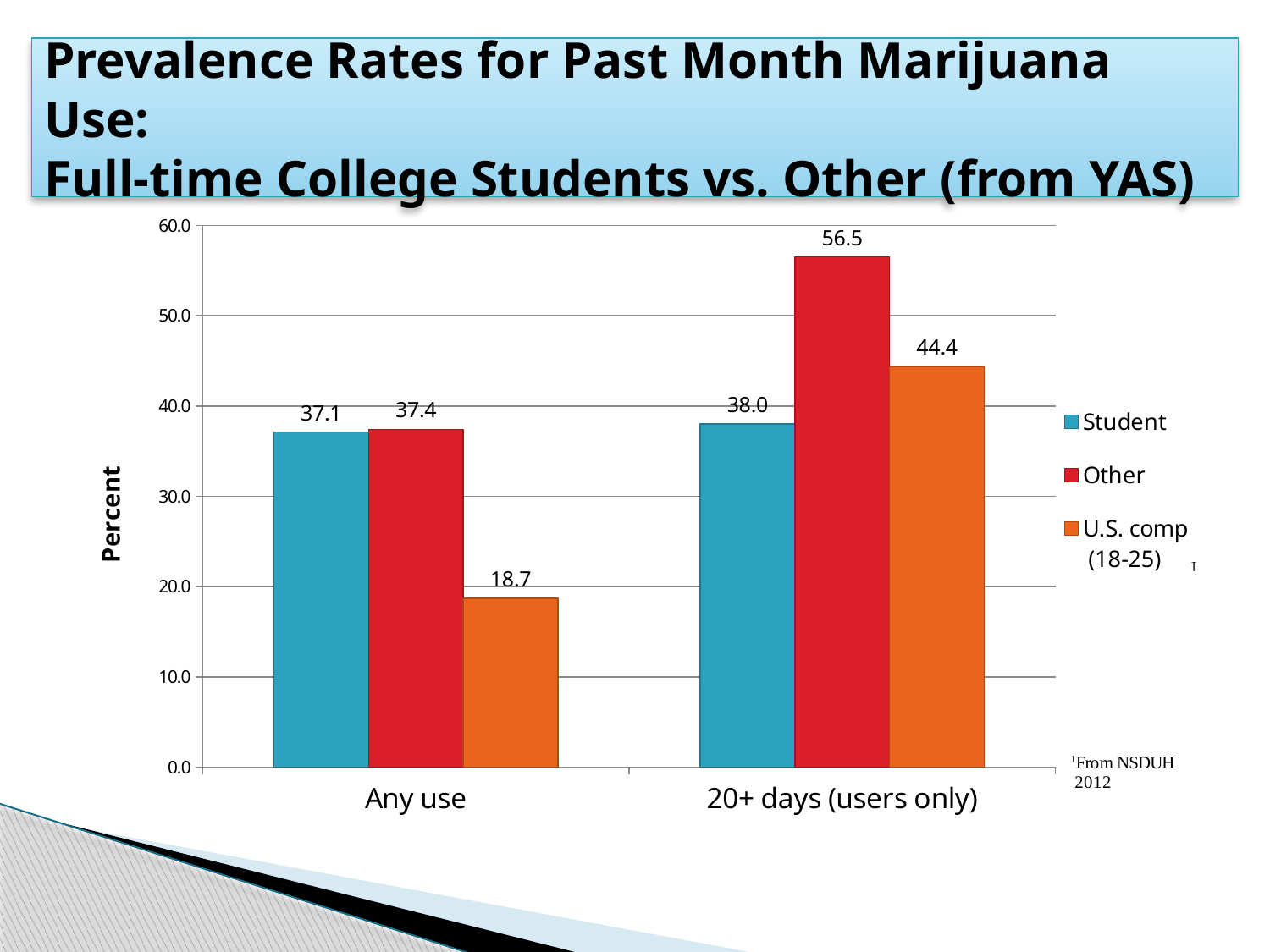
Is the value for Other in the 20+ days (users only) category greater or less than 50.0? greater What is the value for Other in the 20+ days (users only) category? 56.5 What is the difference between the Other and Student values in the 20+ days (users only) category? 18.5 Which is larger in the 20+ days (users only) category: U.S. comp (18-25) or Student? U.S. comp (18-25) What kind of chart is shown on the slide? bar chart Which series has the highest value in the 20+ days (users only) category? Other What is the value for U.S. comp (18-25) in the Any use category? 18.7 Which series has the lowest value in the Any use category? U.S. comp (18-25) How many series does the legend list? 3 How many categories are shown on the x axis? 2 What is the value for Student in the Any use category? 37.1 What is the label of the y axis? Percent